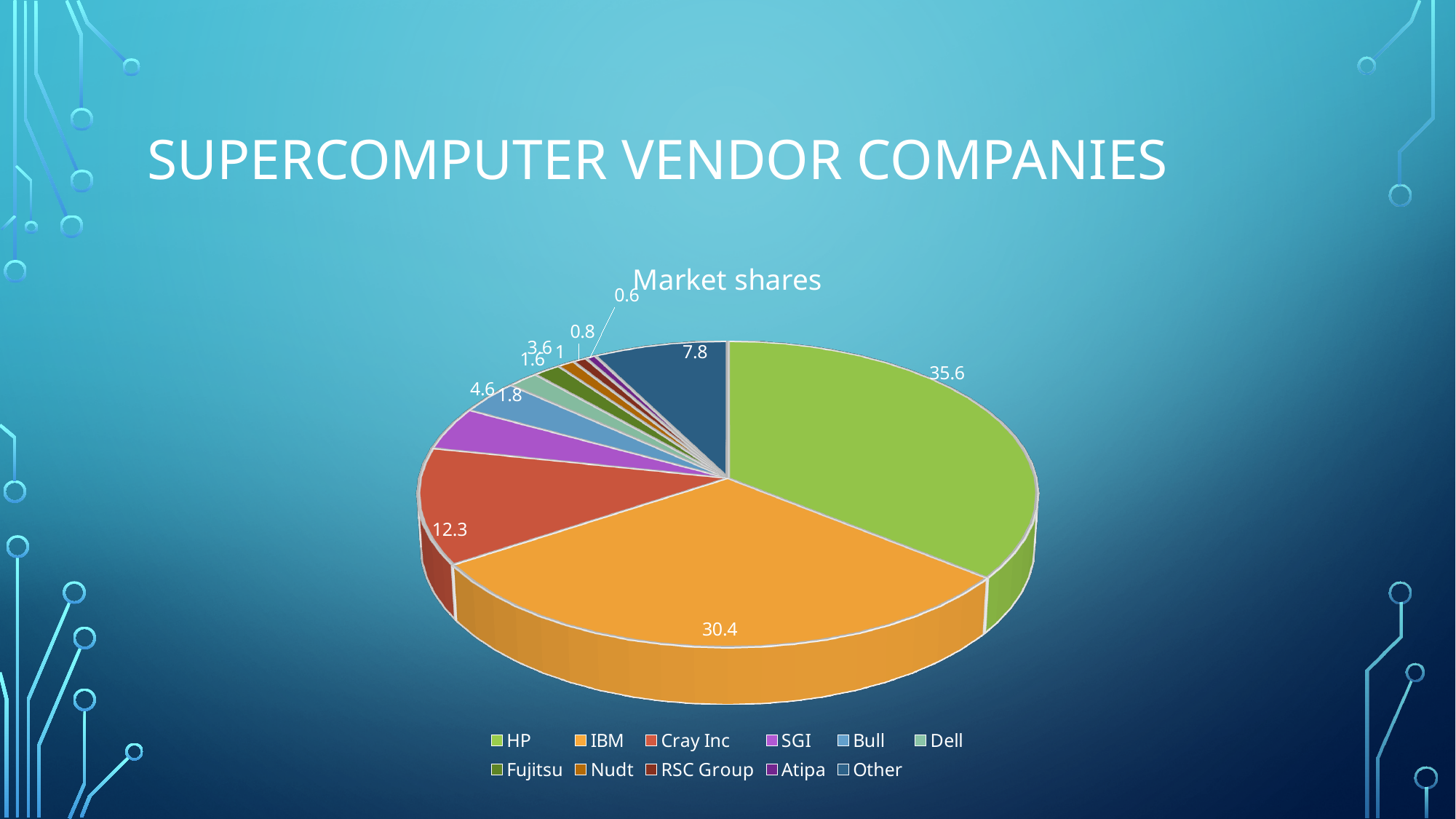
What is the market share value for SGI? 4.6 What is the market share value for Cray Inc? 12.3 Which has a larger market share, Cray Inc or Other? Cray Inc What is the market share value for IBM? 30.4 What is the market share value for Other? 7.8 Which company has the largest market share? HP What is the title of the chart? Market shares What kind of chart is shown on the slide? pie chart How many companies are listed in the chart legend? 11 Which company has the smallest market share? Atipa What is the difference between the market shares of HP and IBM? 5.2 What is the market share value for HP? 35.6